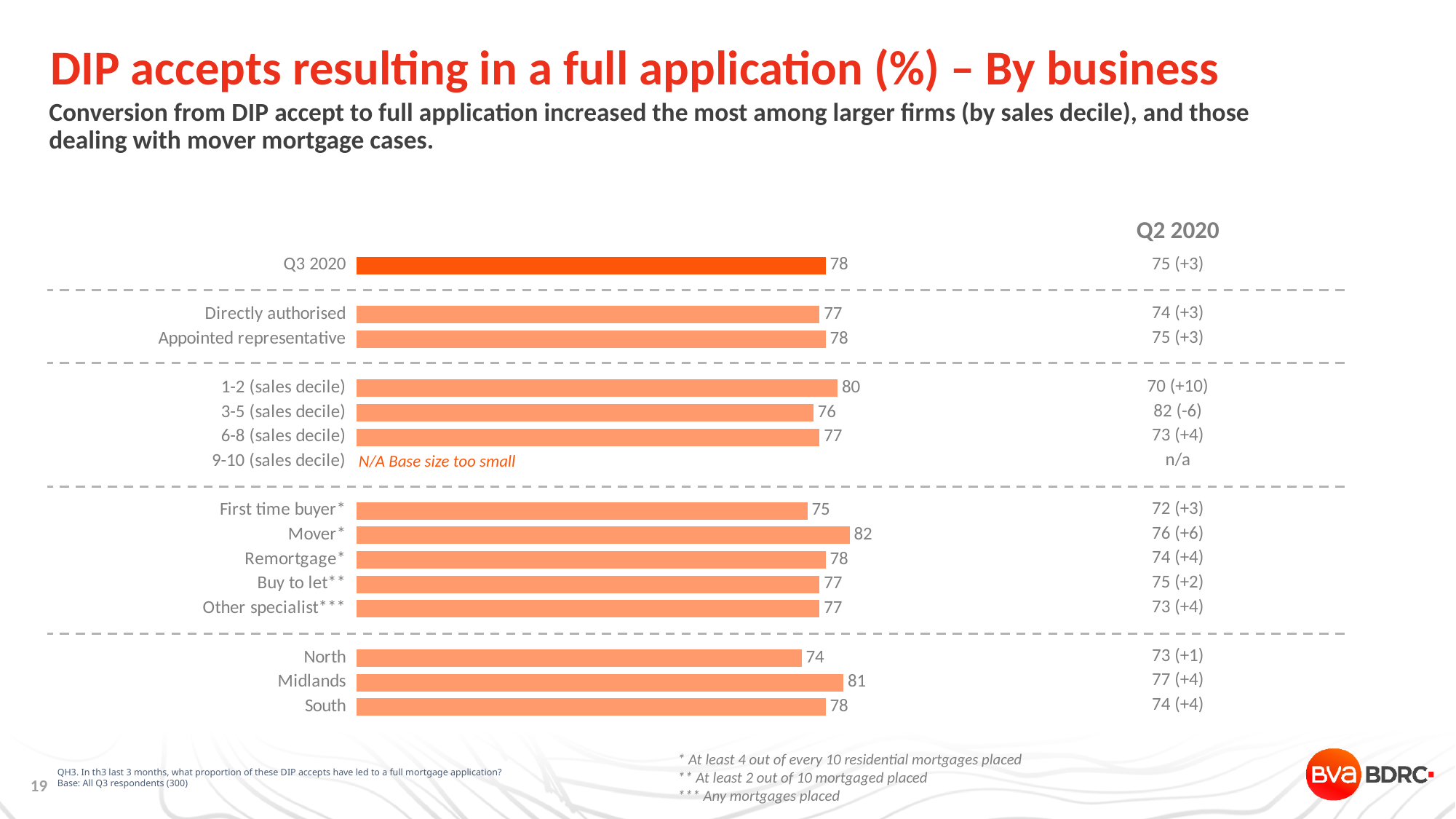
Which has a higher Q3 2020 value, 1-2 (sales decile) or 3-5 (sales decile)? 1-2 (sales decile) What is the value for 1-2 (sales decile) in Q3 2020? 80 What is the value for Mover in Q3 2020? 82 What is the value for North in Q3 2020? 74 Which category has the highest Q3 2020 value? Mover Why is no bar shown for 9-10 (sales decile)? N/A Base size too small What was the Q2 2020 value for 3-5 (sales decile)? 82 (-6) What is the difference between the Q3 2020 values for Mover and First time buyer? 7 Which region has the lowest Q3 2020 value? North What is the difference between the Q3 2020 values for Midlands and North? 7 What kind of chart is shown on the slide? Bar chart What is the overall Q3 2020 value shown at the top of the chart? 78